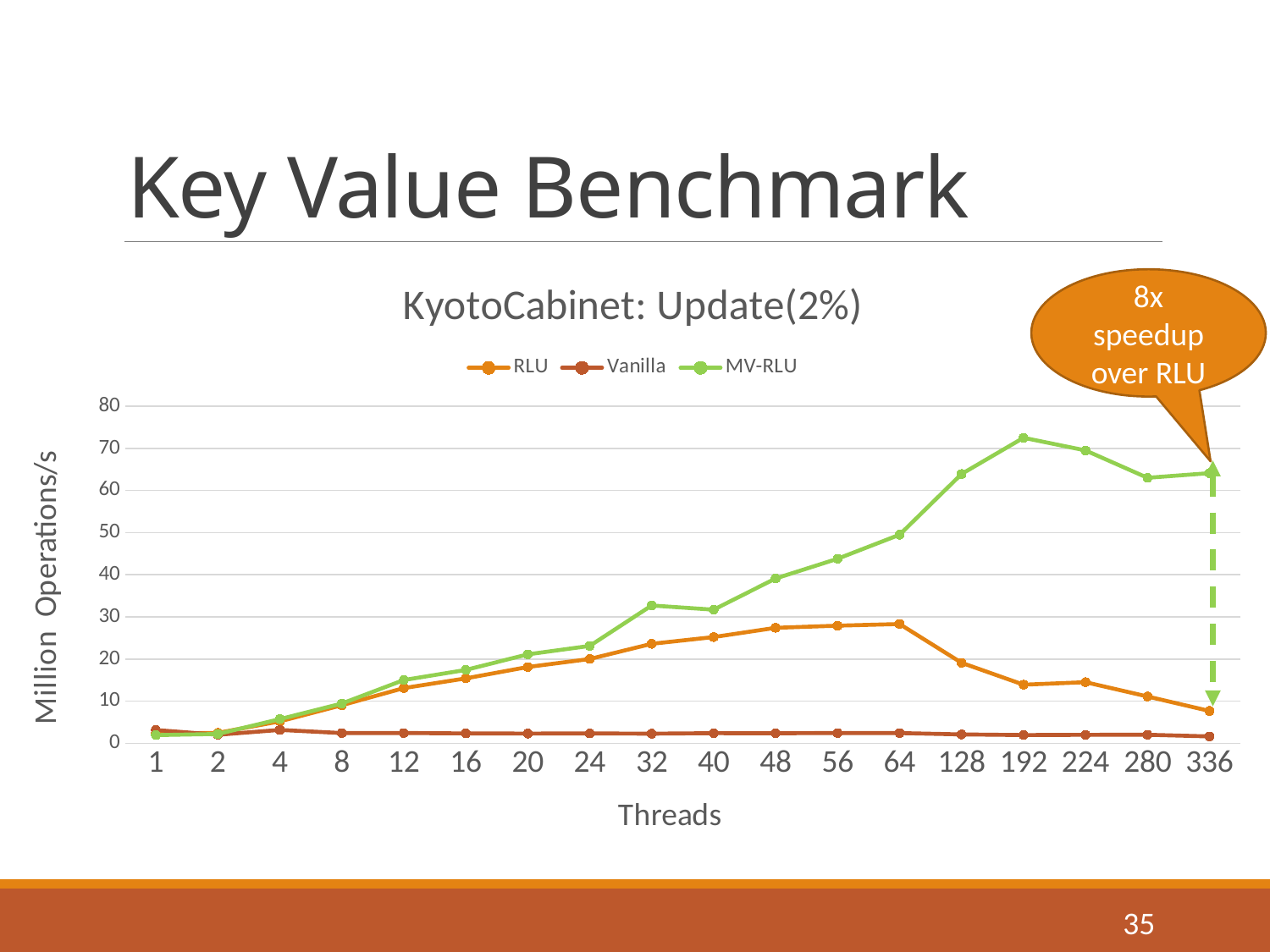
How many thread counts are plotted along the x axis? 18 At 336 threads, which series has the larger value, MV-RLU or RLU? MV-RLU What kind of chart is shown on the slide? line chart What speedup over RLU does the callout on the chart claim? 8x Is the MV-RLU value at 336 threads greater or less than 60? greater Does the RLU series rise or fall between 64 and 336 threads? fall What is the title of the chart? KyotoCabinet: Update(2%) Is the MV-RLU value at 192 threads greater or less than 70? greater Is the RLU value at 336 threads greater or less than 10? less At which thread count does the MV-RLU series reach its highest value? 192 How many series does the legend list? 3